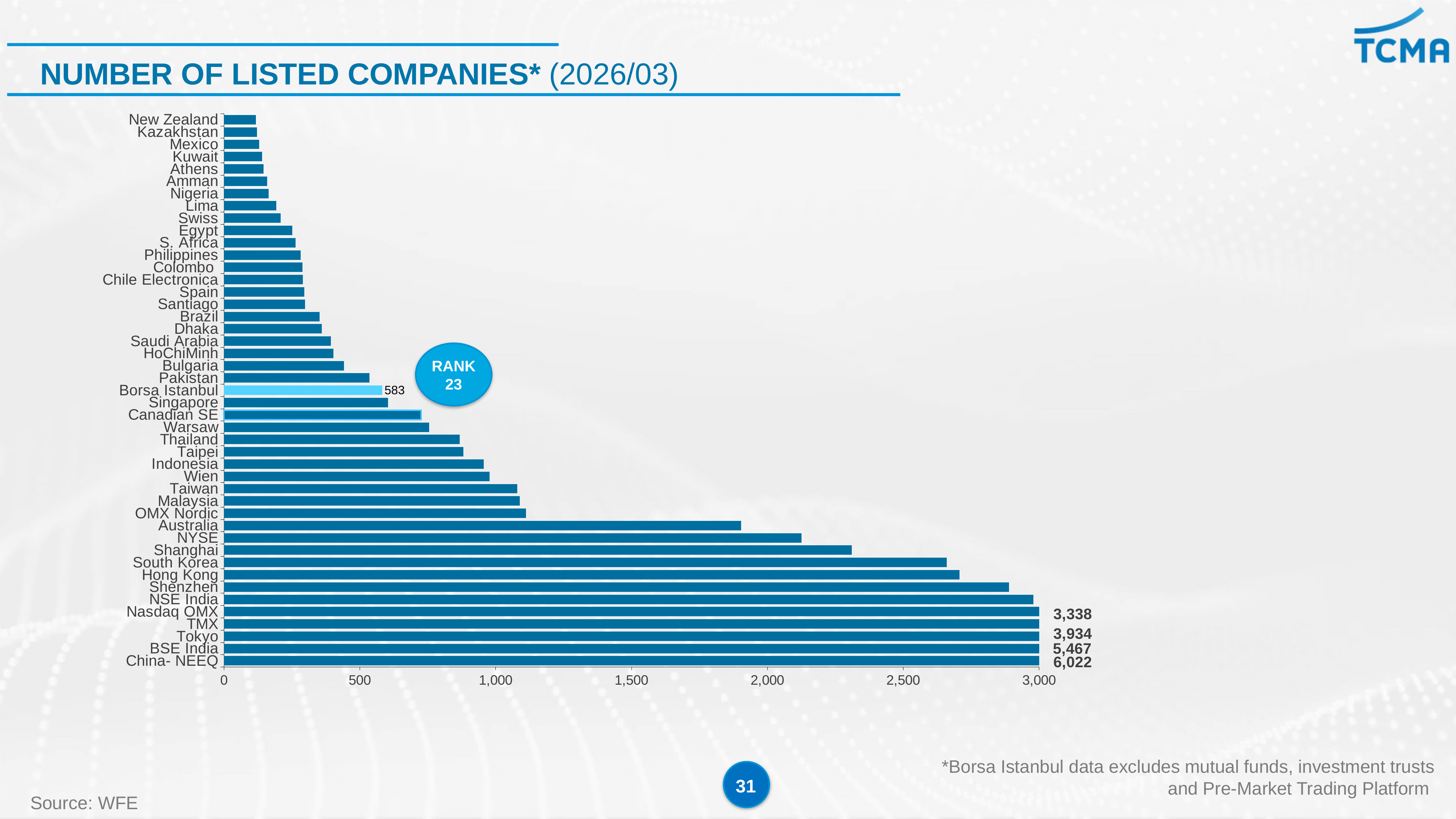
What is the number of listed companies for Tokyo? 3,934 Which has more listed companies, Australia or OMX Nordic? Australia Which exchange has the lowest number of listed companies? New Zealand What is the number of listed companies for China- NEEQ? 6,022 What is the difference between the number of listed companies for China- NEEQ and BSE India? 555 Is the value for Shanghai greater or less than 2,000? greater Is the value for Bulgaria greater or less than 500? less What rank does the slide give Borsa Istanbul? 23 Which exchange has the highest number of listed companies? China- NEEQ What is the number of listed companies for BSE India? 5,467 What type of chart is shown on the slide? bar chart What is the number of listed companies for Borsa Istanbul? 583